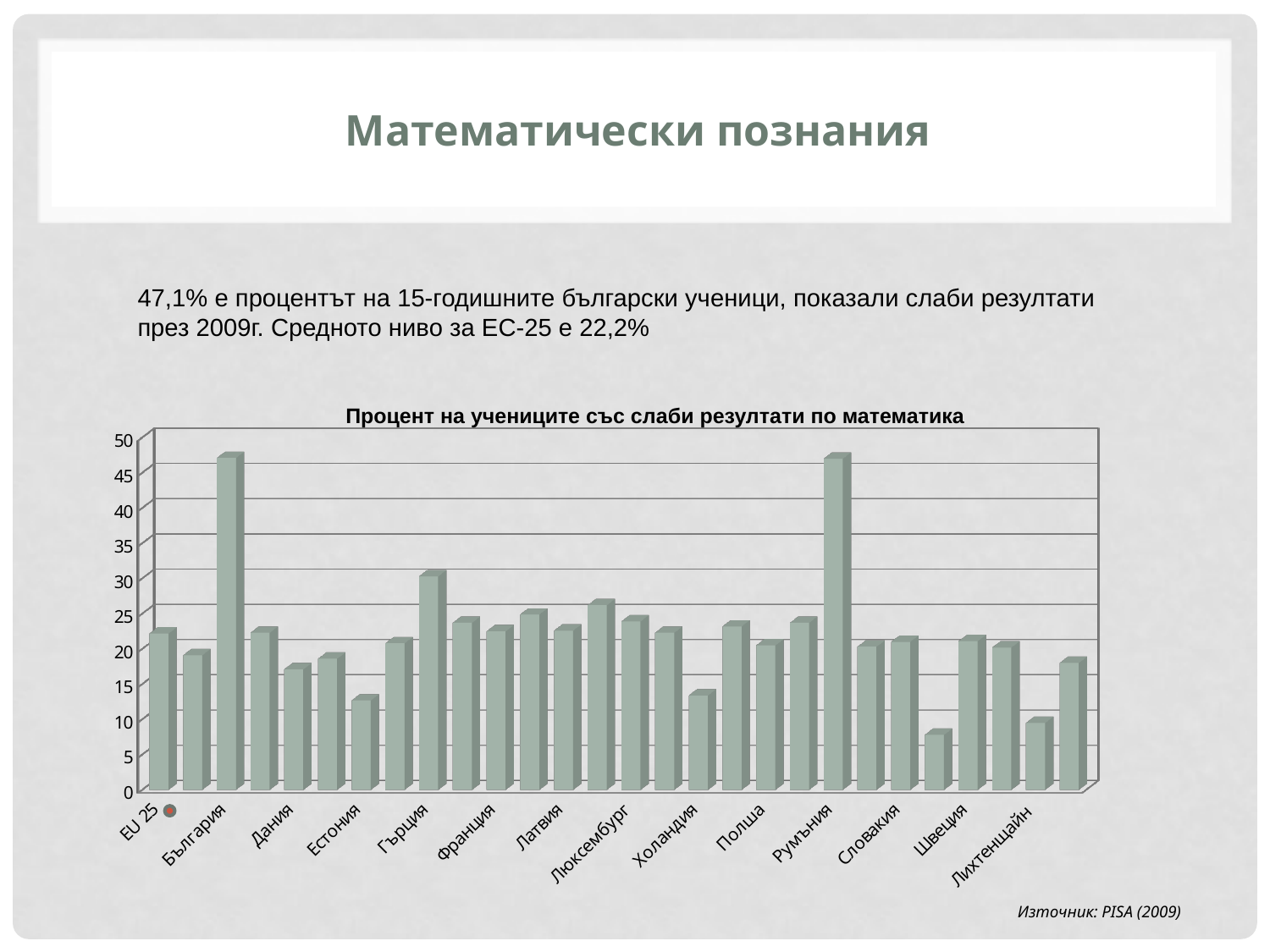
Is the value for Холандия greater or less than 15? less Which has a higher value, Гърция or Дания? Гърция Is the value for Словакия greater or less than 15? greater What kind of chart is shown on the slide? bar chart Is the value for Гърция greater or less than 25? greater What source is cited for the chart data? PISA (2009) According to the slide text, what percentage of 15-year-old Bulgarian students showed weak results in mathematics in 2009? 47,1% According to the slide text, what is the average level for EU-25? 22,2% Which has a higher value, България or Гърция? България Which has a higher value, Холандия or Полша? Полша What is the title of the chart? Процент на учениците със слаби резултати по математика